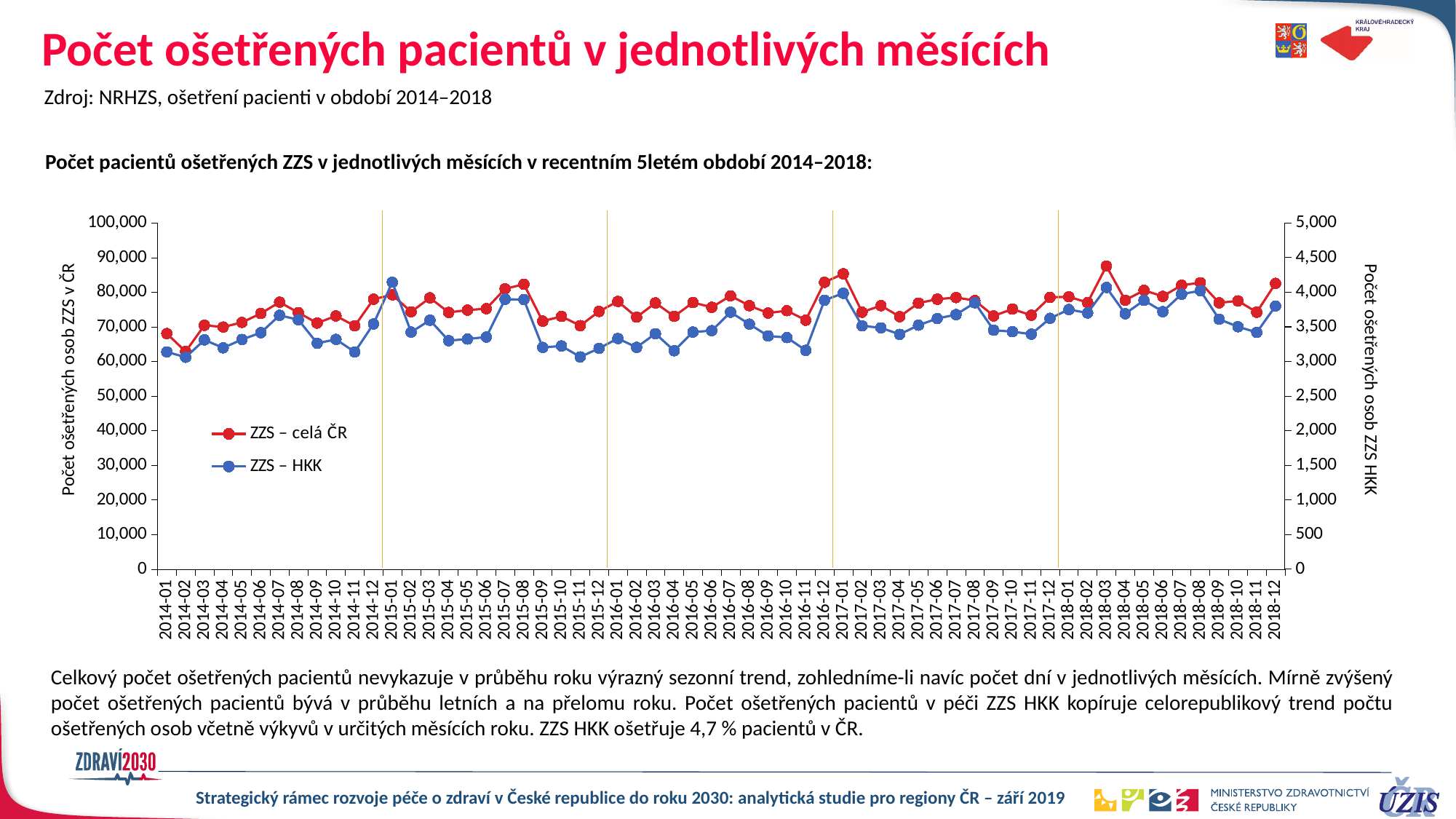
Is the value for ZZS – celá ČR in 2018-03 greater or less than 80,000? greater Which month has the lowest value for the ZZS – celá ČR series? 2014-02 Which month has the highest value for the ZZS – celá ČR series? 2018-03 How many monthly data points are plotted along the x axis of the chart? 60 How many series does the chart legend list? 2 What are the two series named in the chart legend? ZZS – celá ČR and ZZS – HKK On the right axis, is the value for ZZS – HKK in 2014-02 greater or less than 3,500? less On the right axis, is the value for ZZS – HKK in 2015-01 greater or less than 4,000? greater What kind of chart is shown on the slide? line chart What is the title of the left vertical axis of the chart? Počet ošetřených osob ZZS v ČR For the ZZS – celá ČR series, which month has the larger value: 2017-01 or 2017-04? 2017-01